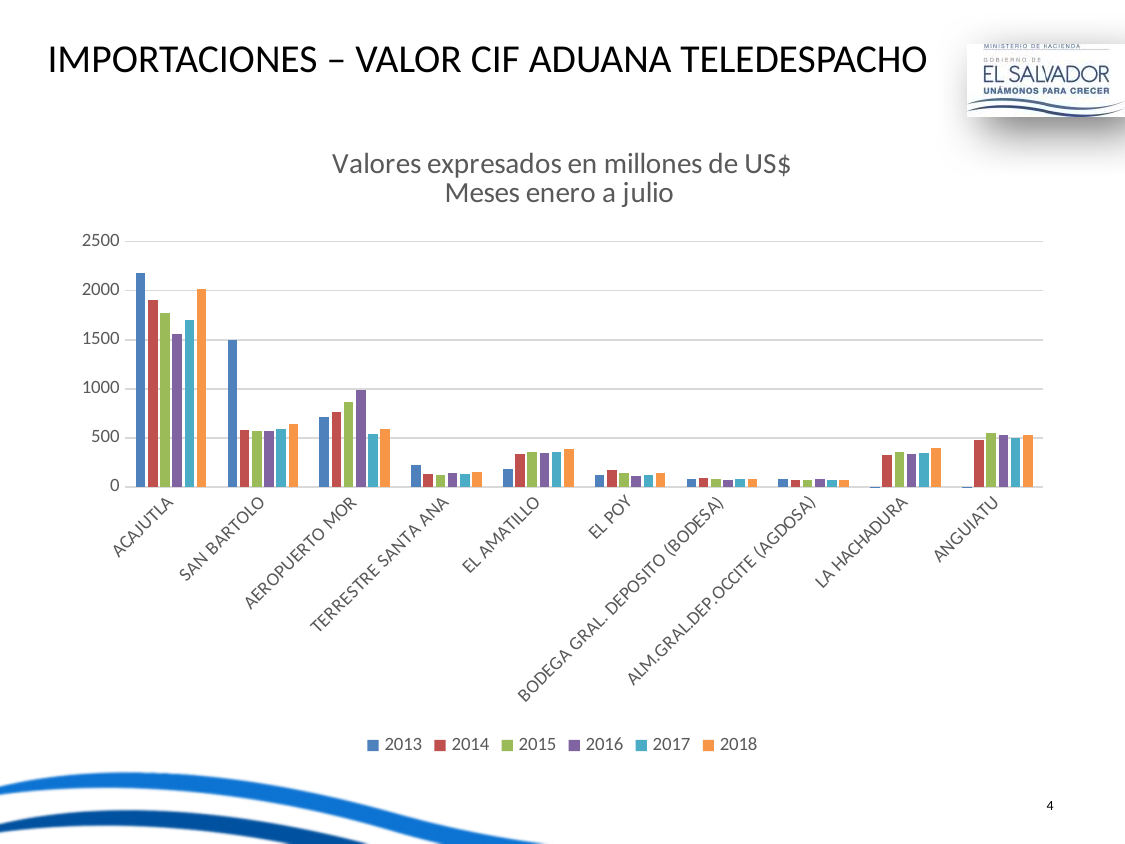
How many series does the legend list? 6 Is the value for SAN BARTOLO in 2014 greater or less than 500? greater For SAN BARTOLO, does the value rise or fall from 2013 to 2014? fall Which is larger for 2013: ACAJUTLA or SAN BARTOLO? ACAJUTLA For AEROPUERTO MOR, which year has the highest value? 2016 Is the value for LA HACHADURA in 2018 greater or less than 500? less What kind of chart is shown on the slide? bar chart For ACAJUTLA, which year has the highest value? 2013 In what units are the values expressed, according to the chart subtitle? millones de US$ How many customs offices (categories) are shown on the x axis? 10 Which customs office has the highest bar in the chart? ACAJUTLA Is the value for ACAJUTLA in 2013 greater or less than 2000? greater